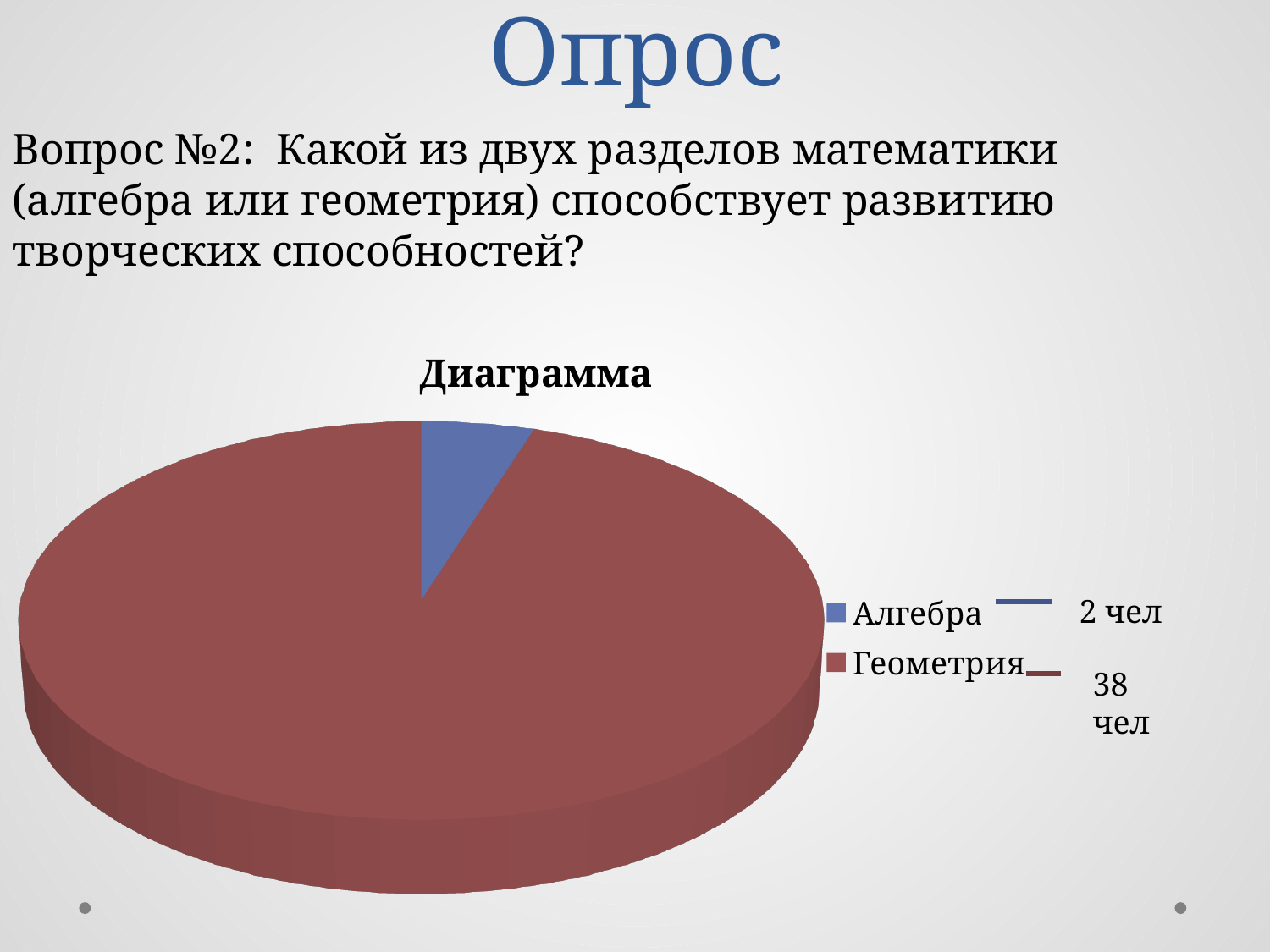
How many people chose Геометрия? 38 чел Which category has the largest slice of the pie? Геометрия What is the title of the chart? Диаграмма Which is larger, the value for Алгебра or the value for Геометрия? Геометрия What kind of chart is shown on the slide? pie chart Which category has the smallest slice of the pie? Алгебра What share of the pie does Геометрия represent? 95% How many entries does the legend list? 2 What is the difference between the number of people who chose Геометрия and those who chose Алгебра? 36 What is the total number of people represented in the pie chart? 40 How many people chose Алгебра? 2 чел How many slices does the pie chart have? 2